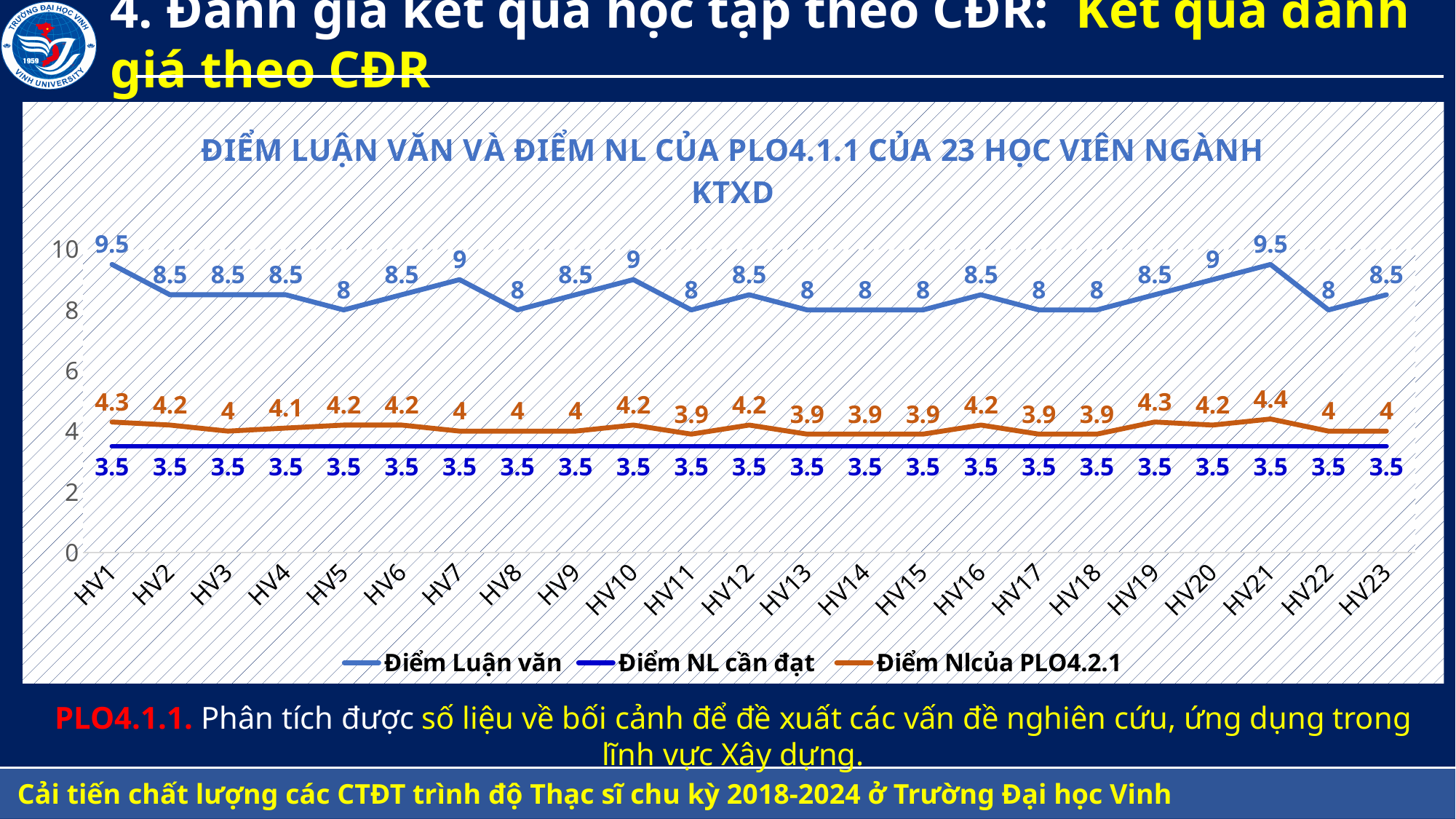
Which is larger, the Điểm Luận văn value for HV10 or for HV11? HV10 What is the Điểm Luận văn value for HV7? 9 What is the difference between the Điểm NLcủa PLO4.2.1 value and the Điểm NL cần đạt value for HV21? 0.9 What is the difference between the Điểm Luận văn values for HV1 and HV2? 1 How many series does the legend list? 3 What kind of chart is shown on the slide? line chart Which category has the highest Điểm NLcủa PLO4.2.1 value? HV21 Which series is drawn in orange? Điểm NLcủa PLO4.2.1 How many categories (học viên) are shown on the x axis? 23 What is the Điểm NLcủa PLO4.2.1 value for HV11? 3.9 What is the Điểm NL cần đạt value for HV15? 3.5 Is the Điểm Luận văn value for HV5 greater or less than 6? greater